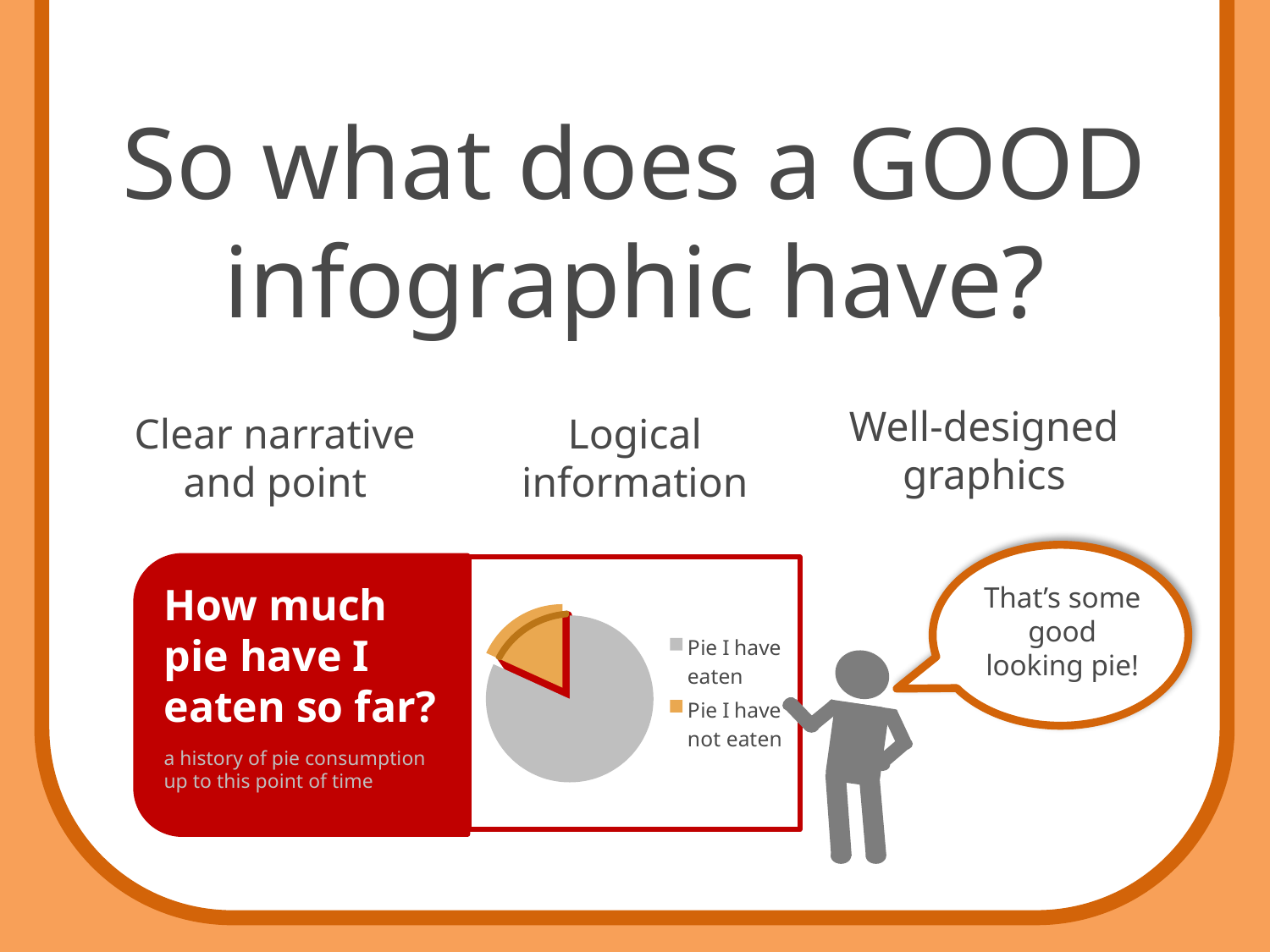
What colour is the 'Pie I have not eaten' slice in the pie chart? Orange How many entries does the pie chart's legend list? 2 Which is larger in the pie chart: 'Pie I have eaten' or 'Pie I have not eaten'? Pie I have eaten Which slice of the pie chart is the largest? Pie I have eaten What kind of chart is shown on the slide? Pie chart What are the two legend entries of the pie chart? Pie I have eaten; Pie I have not eaten Which slice of the pie chart is the smallest? Pie I have not eaten How many slices does the pie chart have? 2